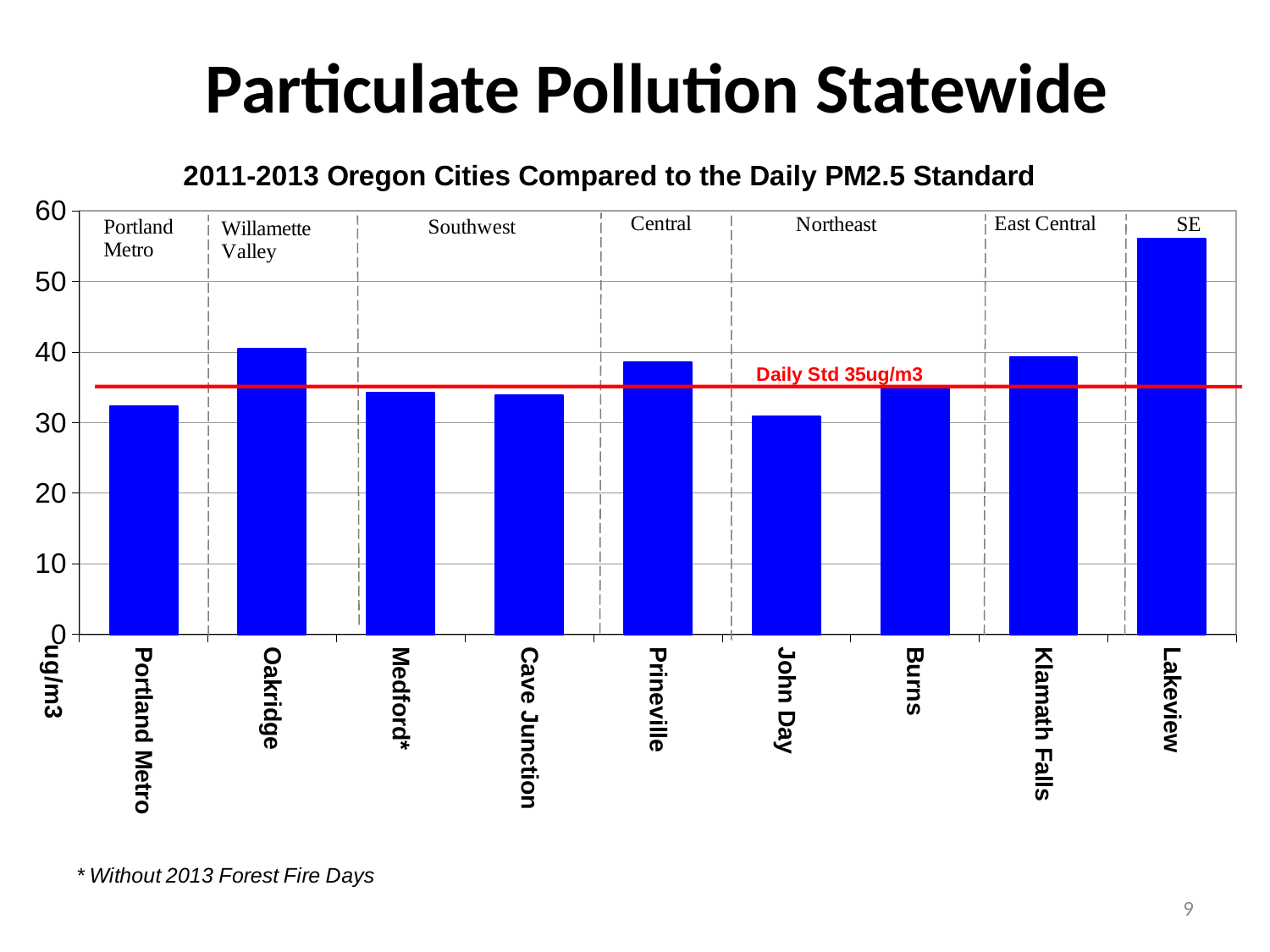
How many cities are plotted in the chart? 9 What value does the red horizontal line labelled Daily Std represent? 35ug/m3 Is the value for John Day greater or less than 35? less Is the value for Oakridge greater or less than 30? greater Which city has the highest PM2.5 value in the chart? Lakeview Is the value for Lakeview greater or less than 50? greater What is the title of the chart? 2011-2013 Oregon Cities Compared to the Daily PM2.5 Standard Which is larger, the value for Prineville or the value for Portland Metro? Prineville Which is larger, the value for Lakeview or the value for Oakridge? Lakeview What kind of chart is shown on the slide? bar chart